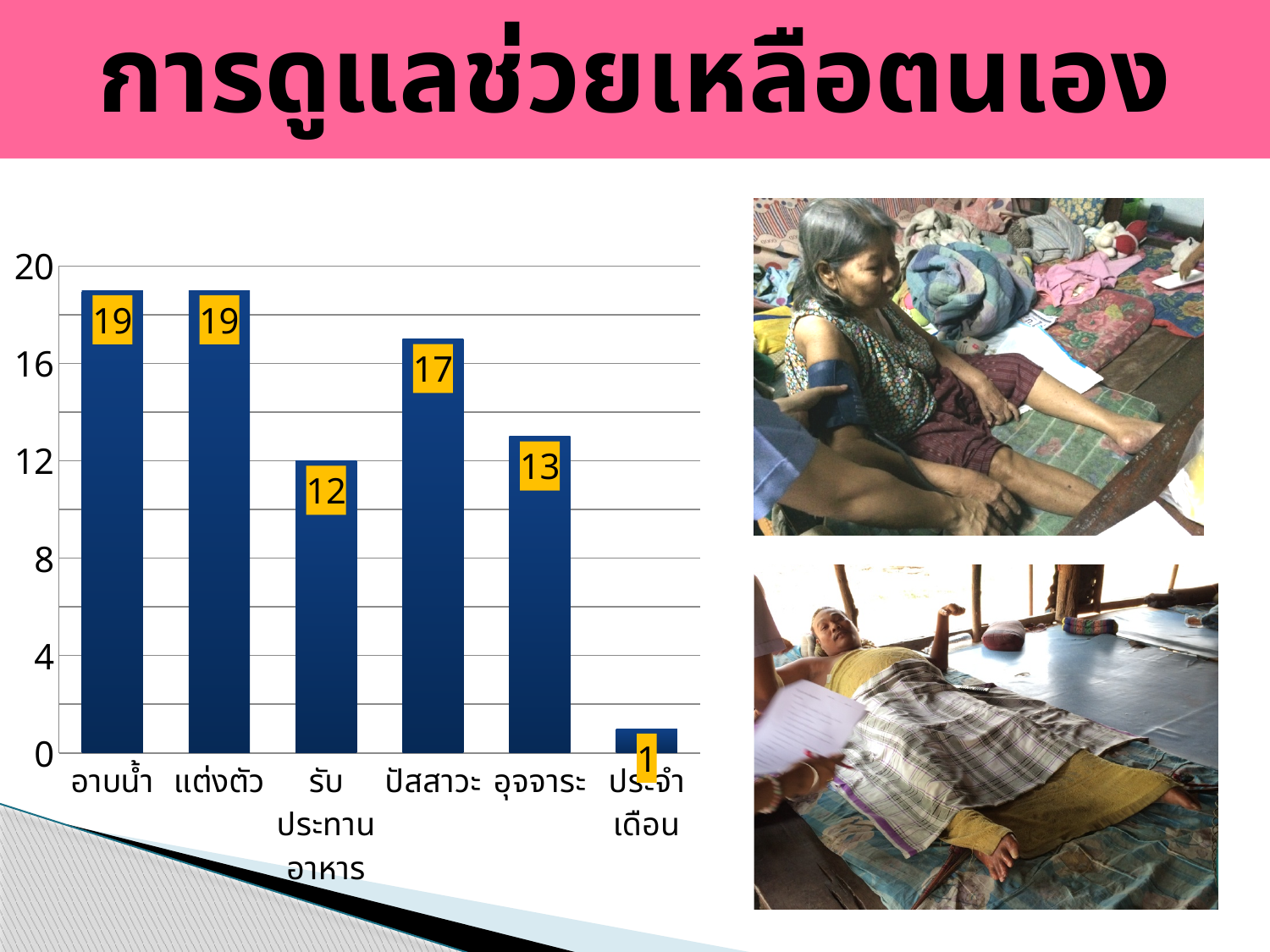
What is the value for ปัสสาวะ? 17 What kind of chart is shown on the slide? bar chart Is the value for อุจจาระ greater or less than 12? greater What is the difference between the values for ปัสสาวะ and อุจจาระ? 4 Which is larger, the value for ปัสสาวะ or the value for อุจจาระ? ปัสสาวะ What is the difference between the values for แต่งตัว and รับประทานอาหาร? 7 What is the value for ประจำเดือน? 1 What is the value for รับประทานอาหาร? 12 What is the value for อุจจาระ? 13 Which category has the lowest value? ประจำเดือน How many categories are shown in the chart? 6 What is the value for อาบน้ำ? 19